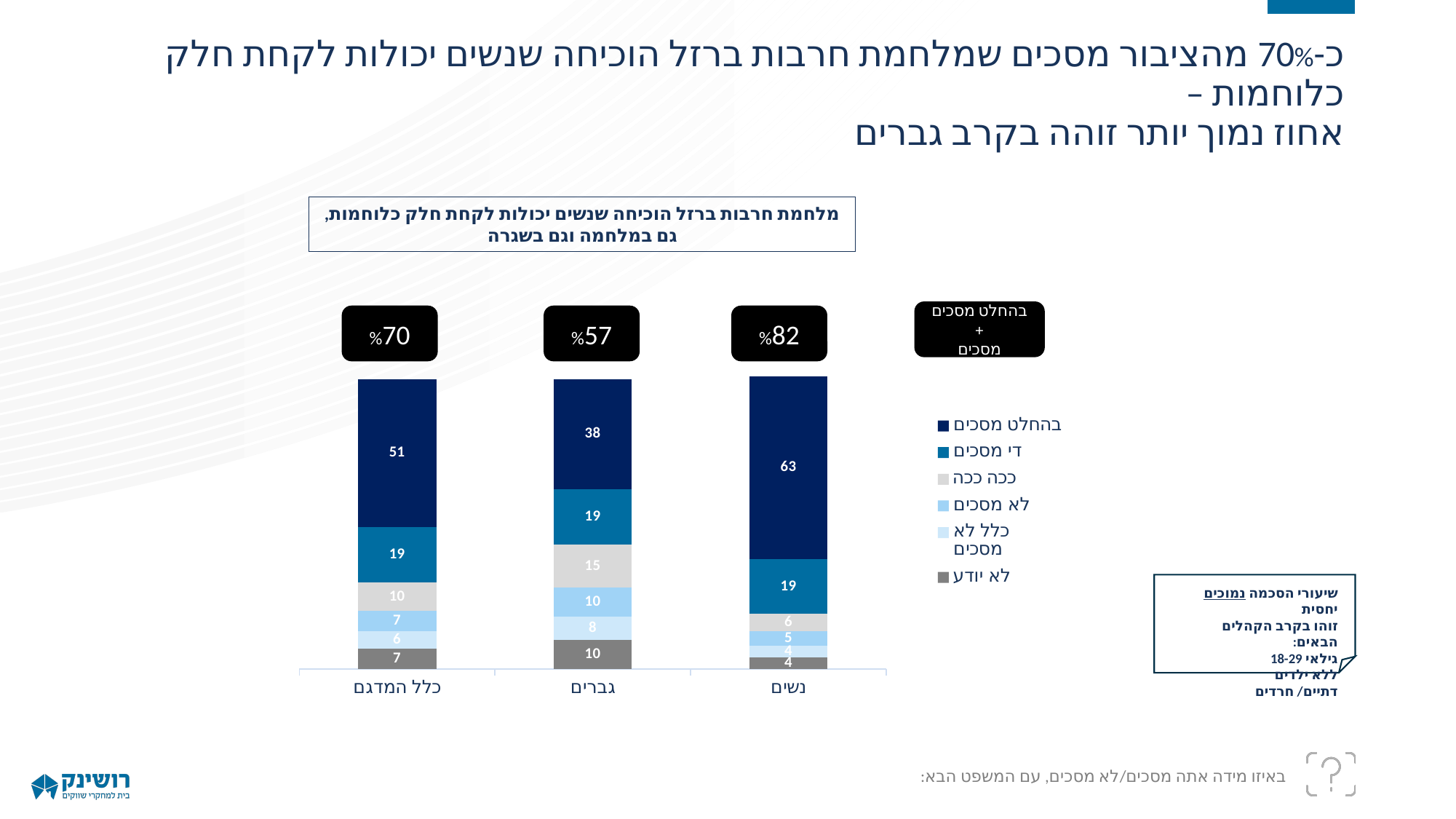
Which category has the lowest combined agreement percentage shown above the bars? גברים How many categories (bars) are shown on the x axis of the chart? 3 What combined percentage (בהחלט מסכים + מסכים) is shown above the 'גברים' (men) bar? %57 How many series does the chart's legend list? 6 What is the value of the 'בהחלט מסכים' (definitely agree) segment for 'נשים' (women)? 63 What is the difference between the 'בהחלט מסכים' (definitely agree) values for 'נשים' (women) and 'גברים' (men)? 25 Which category has the highest 'בהחלט מסכים' (definitely agree) value? נשים What is the value of the 'לא יודע' (don't know) segment for 'כלל המדגם' (total sample)? 7 What kind of chart is shown on the slide? stacked bar chart What is the value of the 'בהחלט מסכים' (definitely agree) segment for 'גברים' (men)? 38 Which is larger: the 'ככה ככה' (so-so) value for 'גברים' (men) or for 'נשים' (women)? גברים What is the total of all segments in the 'גברים' (men) bar? 100